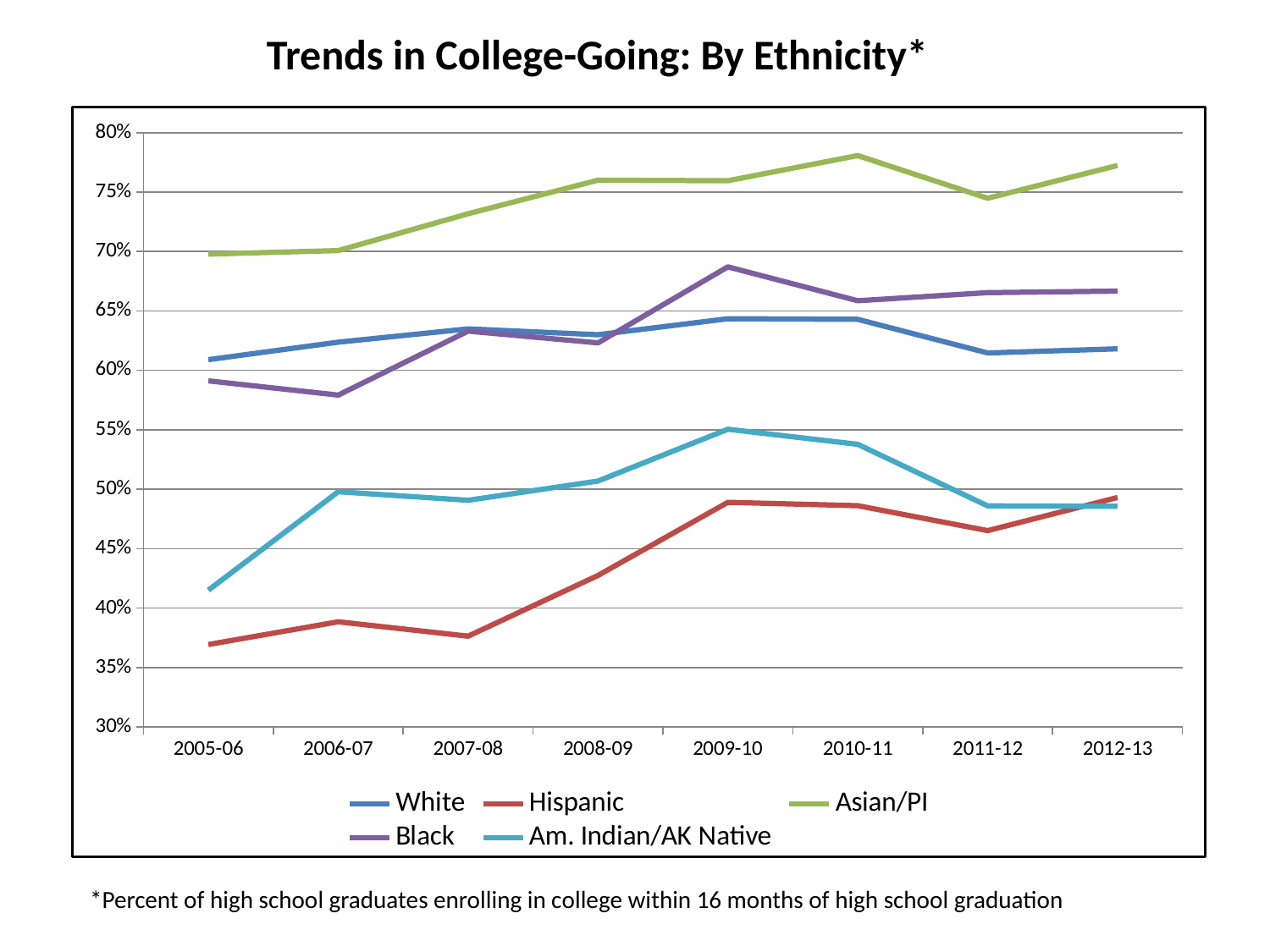
In 2009-10, which is higher: the Black series or the White series? Black Is the value for Asian/PI in 2010-11 greater or less than 75%? greater How many school years are shown along the x axis? 8 Does the Hispanic series overall rise or fall from 2005-06 to 2012-13? rise What kind of chart is shown on the slide? line chart How many series does the legend list? 5 Is the value for Hispanic in 2005-06 greater or less than 40%? less In which school year does the Black series reach its highest value? 2009-10 What is the title of the chart? Trends in College-Going: By Ethnicity* Is the value for Am. Indian/AK Native in 2009-10 greater or less than 50%? greater Which ethnicity has the lowest college-going rate in 2005-06? Hispanic Which ethnicity has the highest college-going rate in 2012-13? Asian/PI